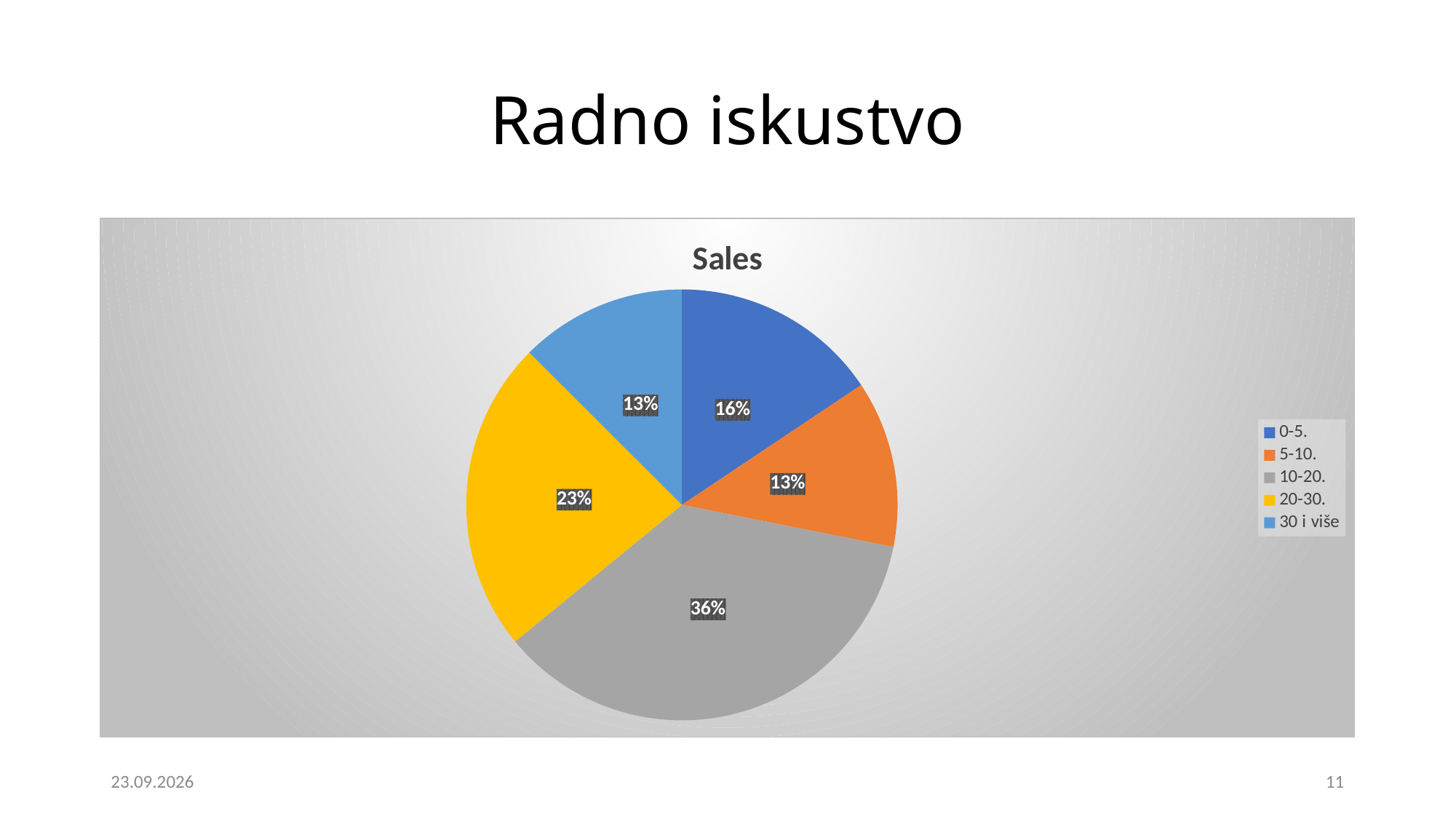
What is the difference in percentage points between the 0-5. slice and the 30 i više slice? 3 Which slice is larger, 0-5. or 20-30.? 20-30. What share of the pie does the 10-20. slice take? 36% How many slices does the pie chart have? 5 Which category has the largest slice of the pie? 10-20. What share of the pie does the 5-10. slice take? 13% Which colour is used for the 20-30. slice? yellow What is the chart's title? Sales What share of the pie does the 20-30. slice take? 23% What is the difference in percentage points between the 10-20. slice and the 20-30. slice? 13 What kind of chart is shown on the slide? pie chart